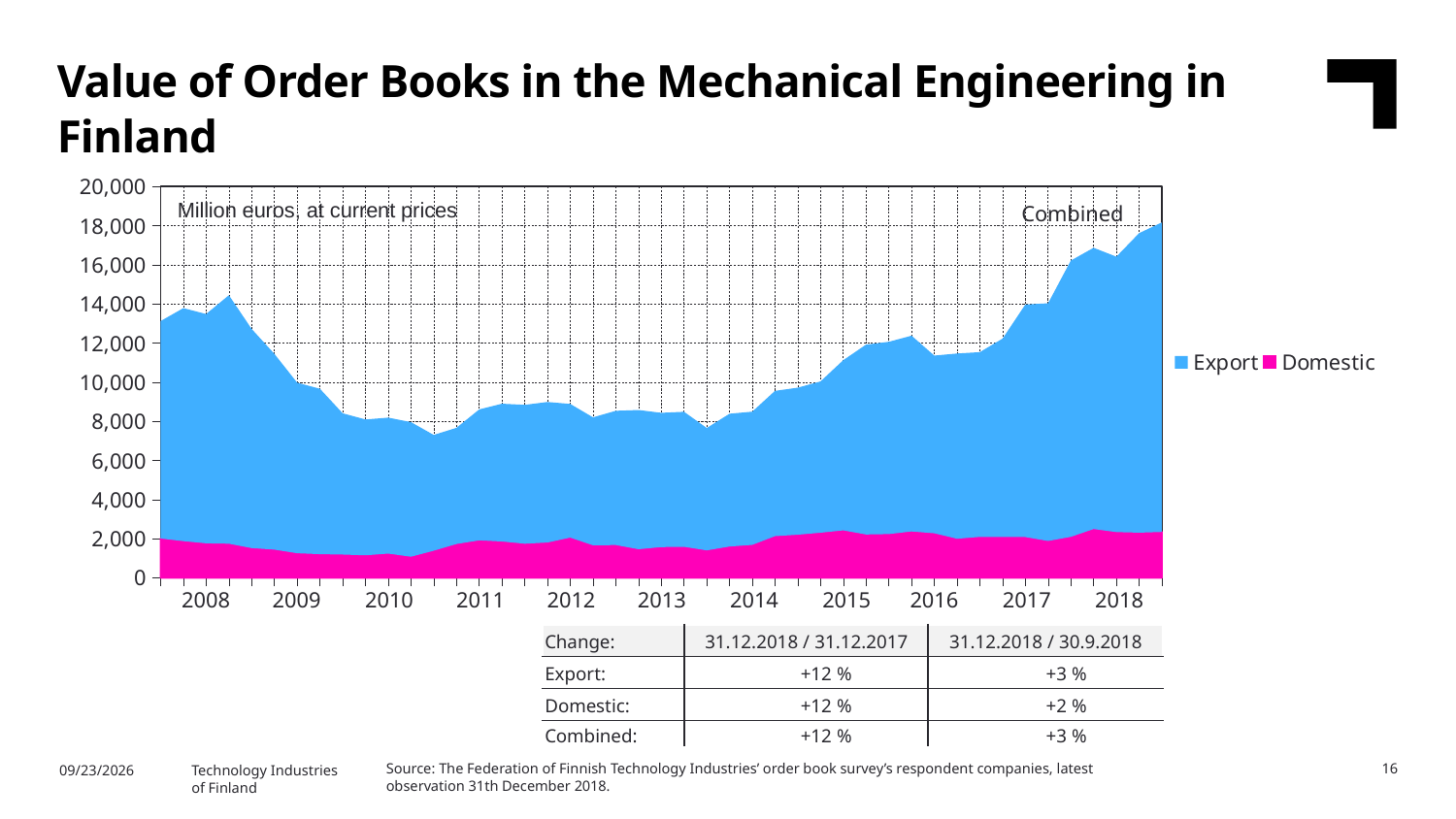
Is the Domestic value at any point in the chart greater or less than 4,000? less Does the combined value of order books rise or fall from 2008 to 2010? fall Is the combined value of order books at the start of 2008 greater or less than 12,000? greater Is the combined value of order books during 2013 greater or less than 10,000? less What kind of chart is shown on the slide? Stacked area chart Does the combined value of order books rise or fall from 2016 to 2018? rise Which two series are listed in the chart legend? Export and Domestic What unit does the chart annotation say the values are in? Million euros, at current prices Which series is larger throughout the chart, Export or Domestic? Export How many series does the chart legend list? 2 How many years are labelled on the x axis of the chart? 11